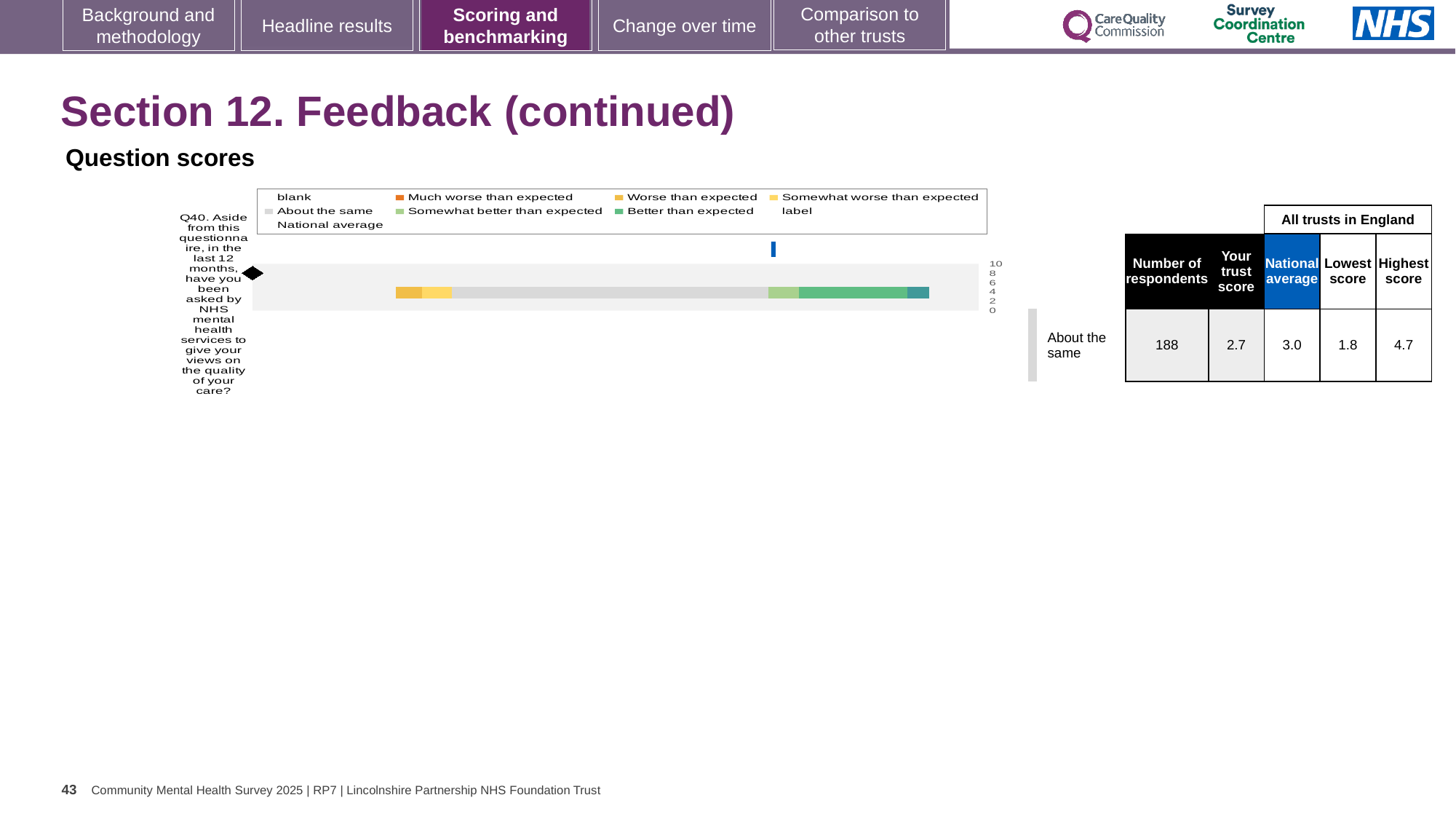
What benchmark category is shown next to the chart for Q40? About the same What is the trust score for Q40 shown in the table beside the chart? 2.7 Which is larger for Q40, the trust score or the national average? National average What is the number of respondents for Q40 shown in the table beside the chart? 188 What is the lowest score among all trusts in England for Q40? 1.8 Which question is plotted in the chart? Q40. Aside from this questionnaire, in the last 12 months, have you been asked by NHS mental health services to give your views on the quality of your care? What is the national average for Q40 shown in the table beside the chart? 3.0 What is the highest score among all trusts in England for Q40? 4.7 What is the difference between the highest score and the lowest score for Q40? 2.9 What kind of chart is shown on the slide for Q40? Bar chart How many questions (categories) are plotted in the chart? 1 What colour is the 'Better than expected' segment in the chart legend? Green